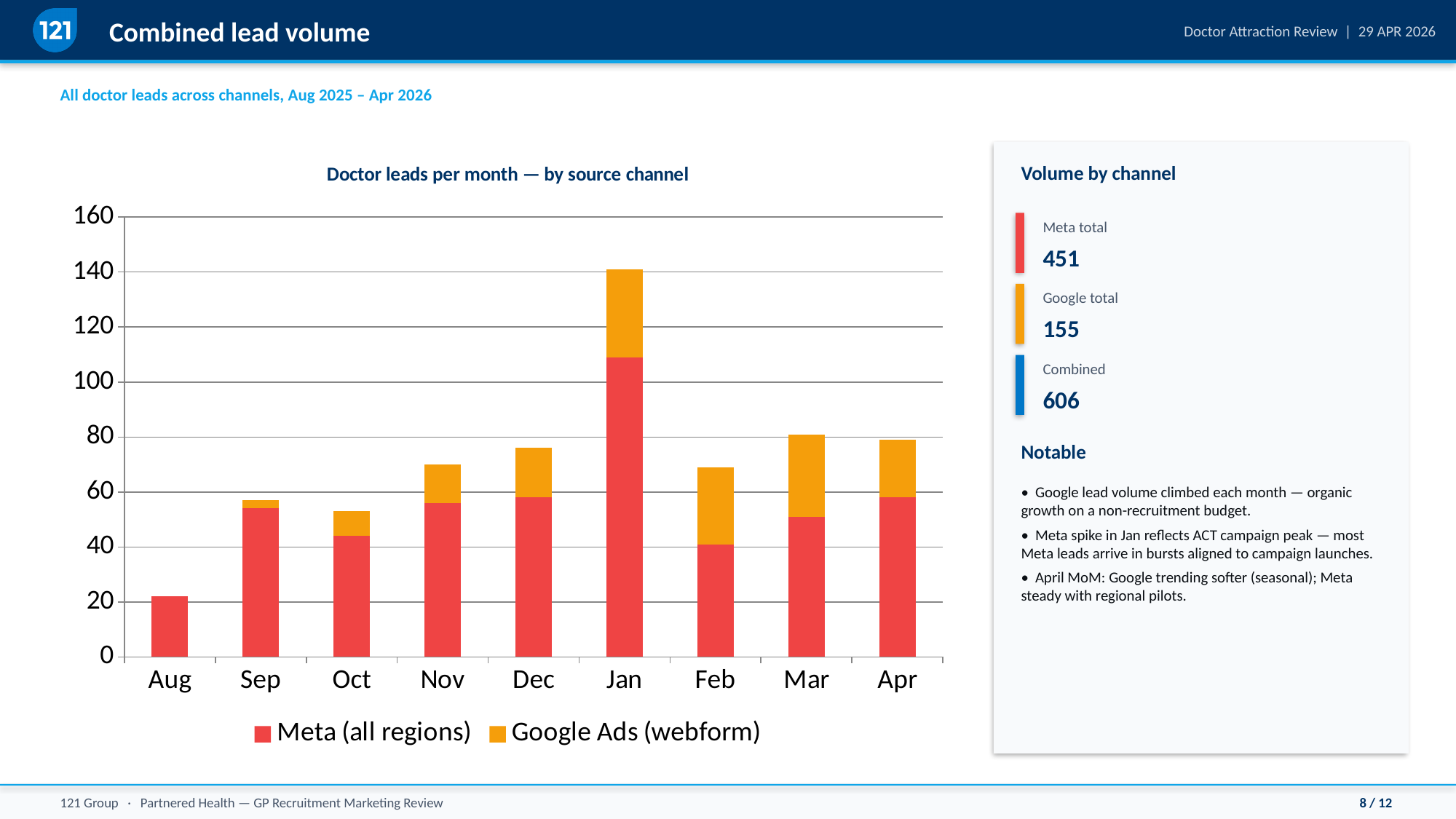
Which month has the larger Google Ads (webform) segment, Jan or Sep? Jan Is the Meta (all regions) segment for Jan greater or less than 100? greater What is the title of the chart? Doctor leads per month — by source channel How many months are shown on the x axis of the chart? 9 What kind of chart is shown on the slide? bar chart How many series does the chart legend list? 2 Is the total bar for Aug greater or less than 40? less Which month has the taller total bar, Mar or Feb? Mar Which month has the highest total bar in the chart? Jan What are the two series named in the chart legend? Meta (all regions) and Google Ads (webform) Is the total bar for Jan greater or less than 120? greater Which month has the lowest total bar in the chart? Aug